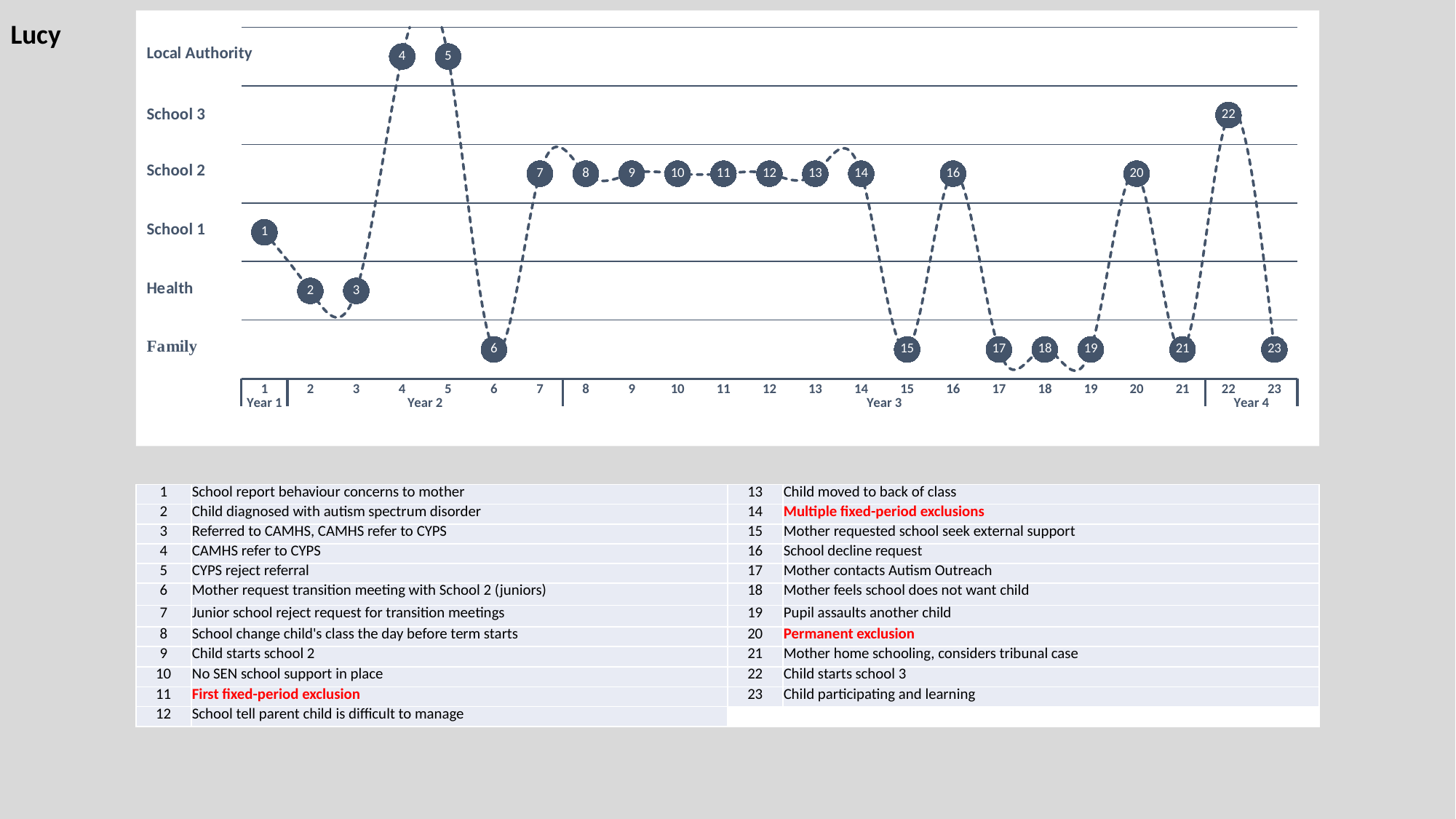
What is the name shown at the top left of the slide? Lucy Which year group contains events 8 through 21? Year 3 Which vertical-axis category does event 1 fall under? School 1 Which vertical-axis category do events 2 and 3 fall under? Health How many year groups are marked along the horizontal axis? 4 Which vertical-axis category does event 4 fall under? Local Authority Which vertical-axis category does event 6 fall under? Family What kind of chart is shown on the slide? Line chart How many numbered event points are plotted on the chart? 23 How many category levels are labelled on the vertical axis of the chart? 6 Which vertical-axis category does event 22 fall under? School 3 Which events are plotted at the Local Authority level? 4 and 5